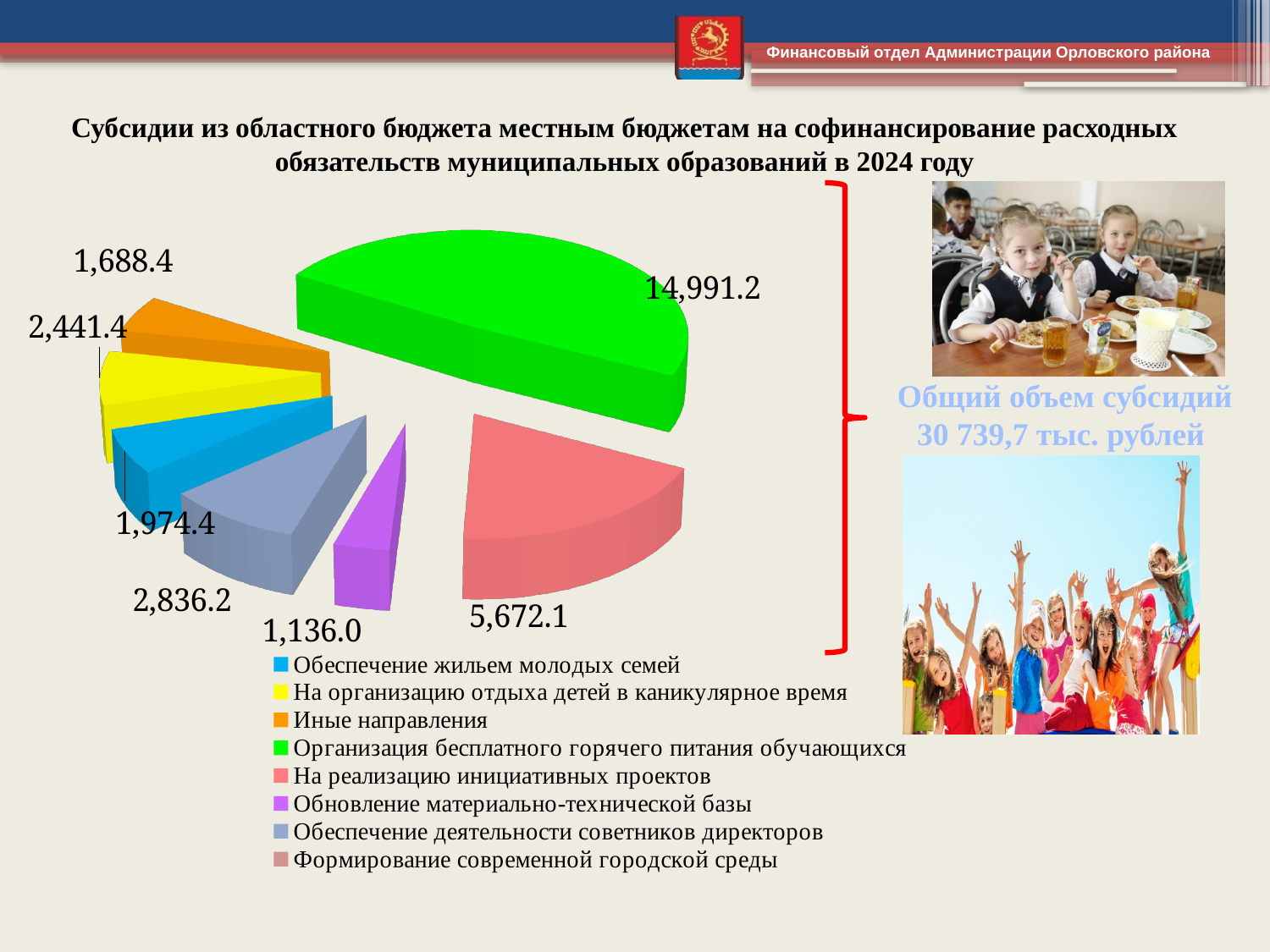
What is the value for Обеспечение деятельности советников директоров? 2,836.2 What total volume of subsidies is stated on the slide? 30 739,7 тыс. рублей Which is larger: На организацию отдыха детей в каникулярное время or Иные направления? На организацию отдыха детей в каникулярное время What kind of chart is shown on the slide? Pie chart What is the value for Организация бесплатного горячего питания обучающихся? 14,991.2 What is the value for Обеспечение жильем молодых семей? 1,974.4 Which labelled slice has the smallest value? Обновление материально-технической базы How many entries does the legend list? 8 What is the difference between the values for Организация бесплатного горячего питания обучающихся and На реализацию инициативных проектов? 9,319.1 Which category has the largest slice of the pie? Организация бесплатного горячего питания обучающихся What is the value for Обновление материально-технической базы? 1,136.0 What is the value for На реализацию инициативных проектов? 5,672.1